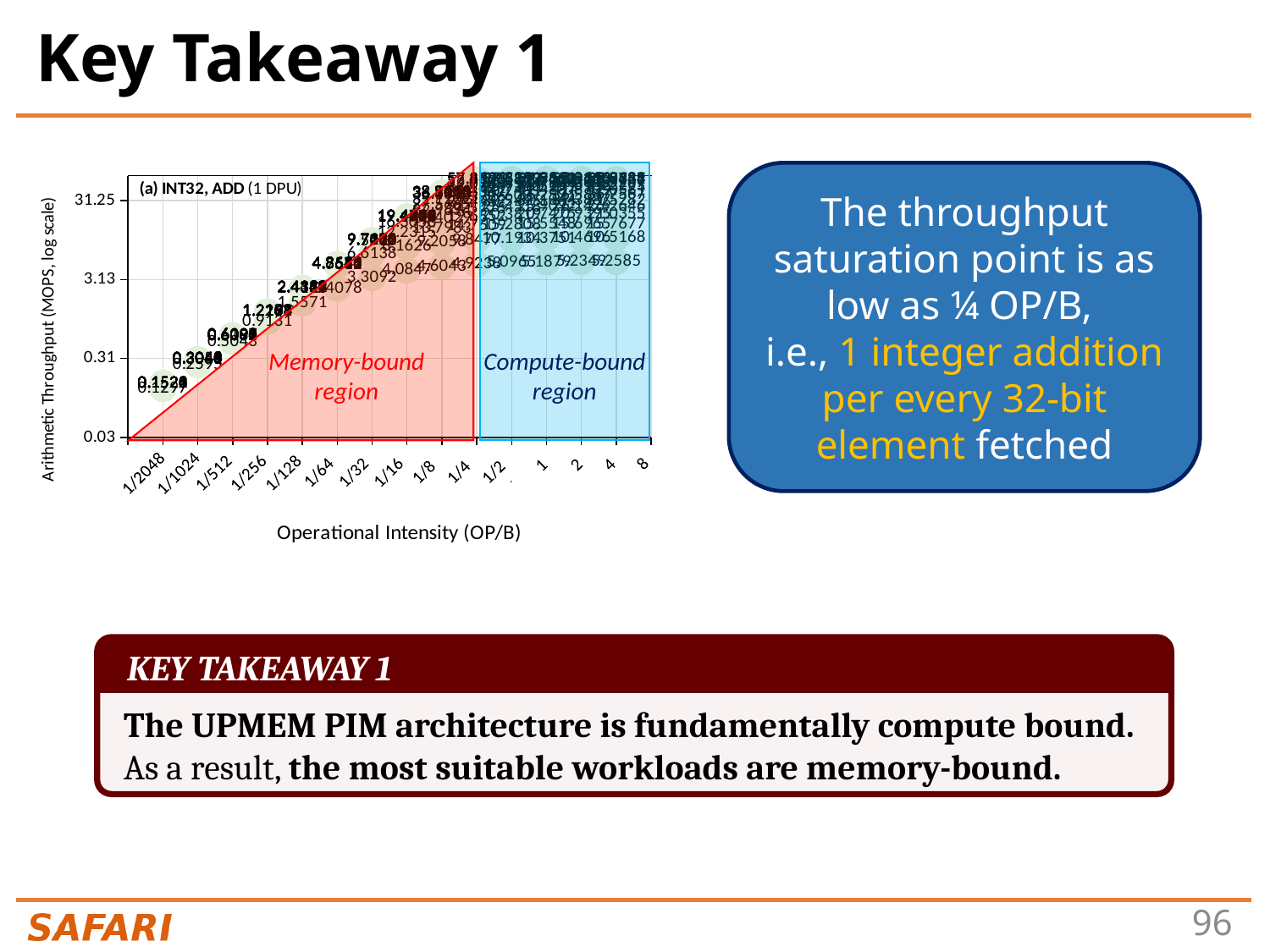
In the memory-bound region, does arithmetic throughput rise or fall as operational intensity increases? rise How many operational intensity values are marked on the x axis of the chart? 15 Which has higher arithmetic throughput: operational intensity 1/2048 or operational intensity 8? 8 Is the arithmetic throughput at operational intensity 1/128 greater or less than 3.13 MOPS? less What is the title printed inside the chart? (a) INT32, ADD (1 DPU) Is the arithmetic throughput at operational intensity 1/512 greater or less than 0.31 MOPS? greater Is the arithmetic throughput at operational intensity 1/2048 greater or less than 0.31 MOPS? less What is the label of the chart's x axis? Operational Intensity (OP/B) What kind of chart is shown on the slide? scatter chart Which has higher arithmetic throughput: operational intensity 1/1024 or operational intensity 1/64? 1/64